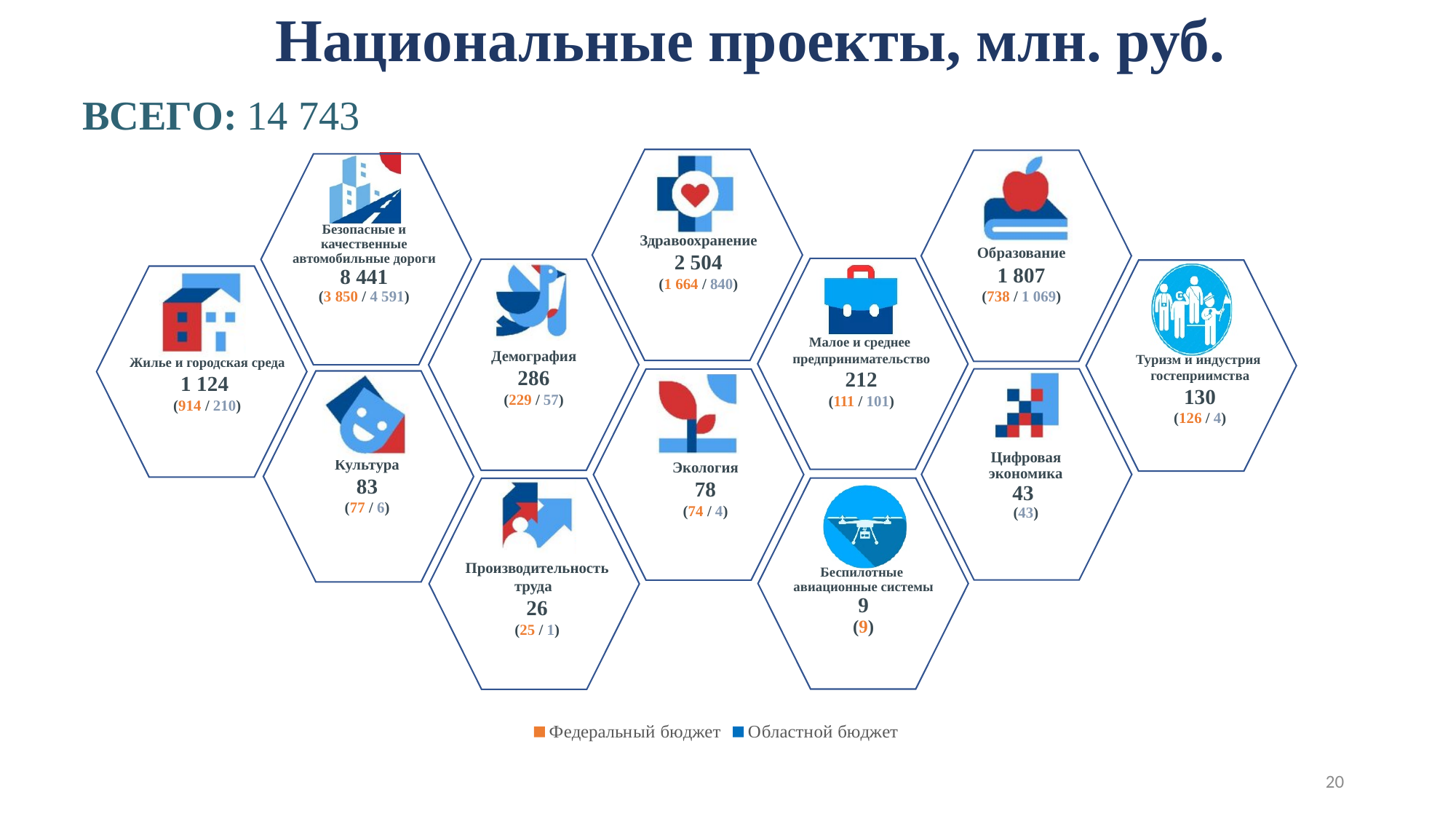
What is the federal budget (Федеральный бюджет) amount for "Образование"? 738 Which national project has the highest total value? Безопасные и качественные автомобильные дороги How many national projects are shown on the slide? 12 What is the regional budget (Областной бюджет) amount for "Безопасные и качественные автомобильные дороги"? 4 591 Which has a larger total value, "Культура" or "Экология"? Культура Which national project has the lowest total value? Беспилотные авиационные системы How many budget series does the legend list? 2 What is the difference between the federal and regional budget amounts for "Малое и среднее предпринимательство"? 10 What is the total value for the national project "Здравоохранение"? 2 504 What is the overall total (ВСЕГО) shown on the slide? 14 743 What is the difference between the total values of "Жилье и городская среда" and "Демография"? 838 Which legend entry is shown in orange? Федеральный бюджет